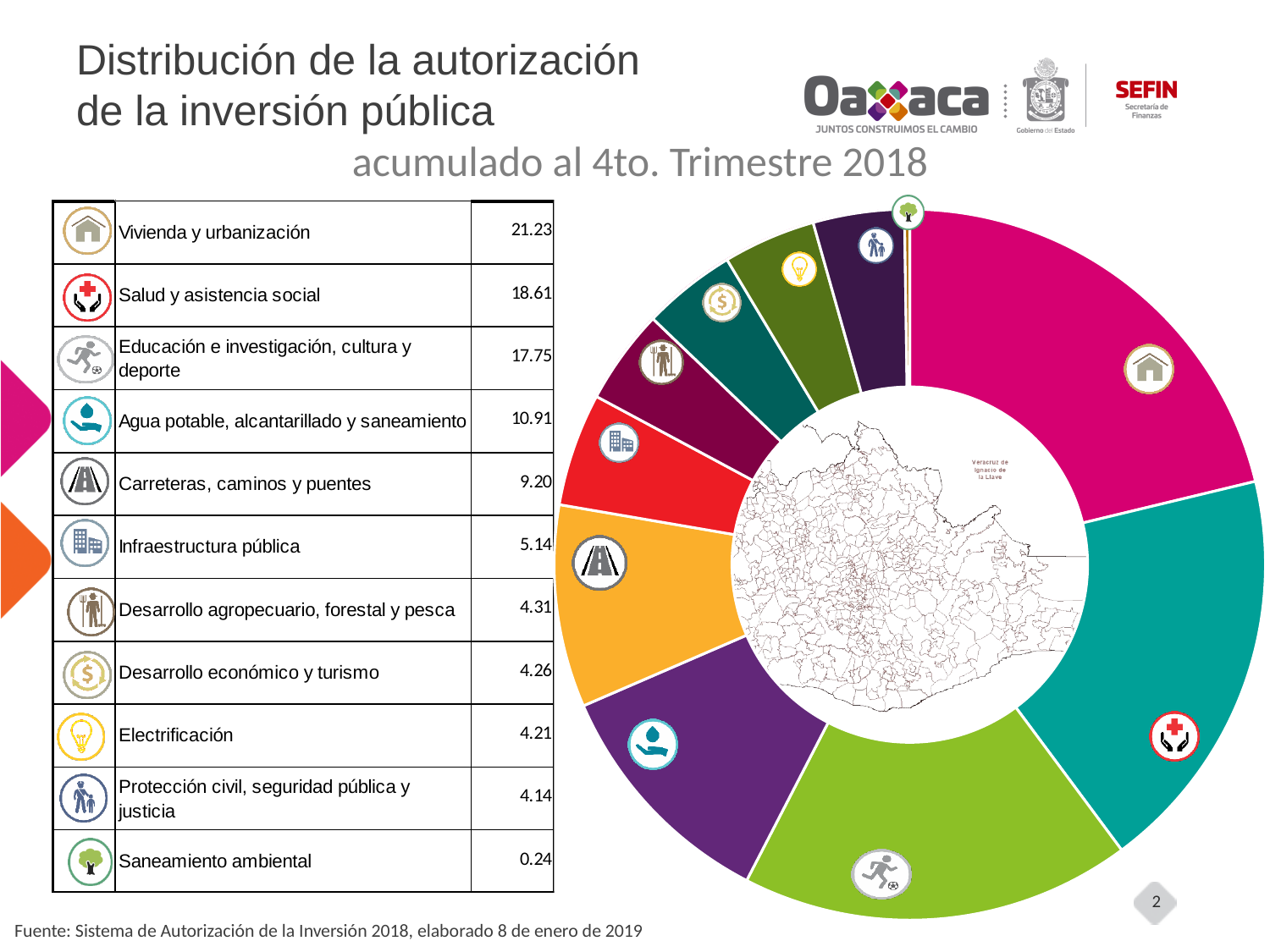
What is the value for Carreteras, caminos y puentes? 9.20 What is the value for Saneamiento ambiental? 0.24 What is the difference between the values for Vivienda y urbanización and Salud y asistencia social? 2.62 What is the value for Electrificación? 4.21 What kind of chart is shown on the slide? Pie chart (donut) Which category has the smallest share of the chart? Saneamiento ambiental Which category has the largest share of the chart? Vivienda y urbanización What is the difference between the values for Infraestructura pública and Desarrollo agropecuario, forestal y pesca? 0.83 What is the value for Vivienda y urbanización? 21.23 Which is larger, Agua potable, alcantarillado y saneamiento or Carreteras, caminos y puentes? Agua potable, alcantarillado y saneamiento How many categories are shown in the chart? 11 What period does the chart subtitle say the data is accumulated to? acumulado al 4to. Trimestre 2018